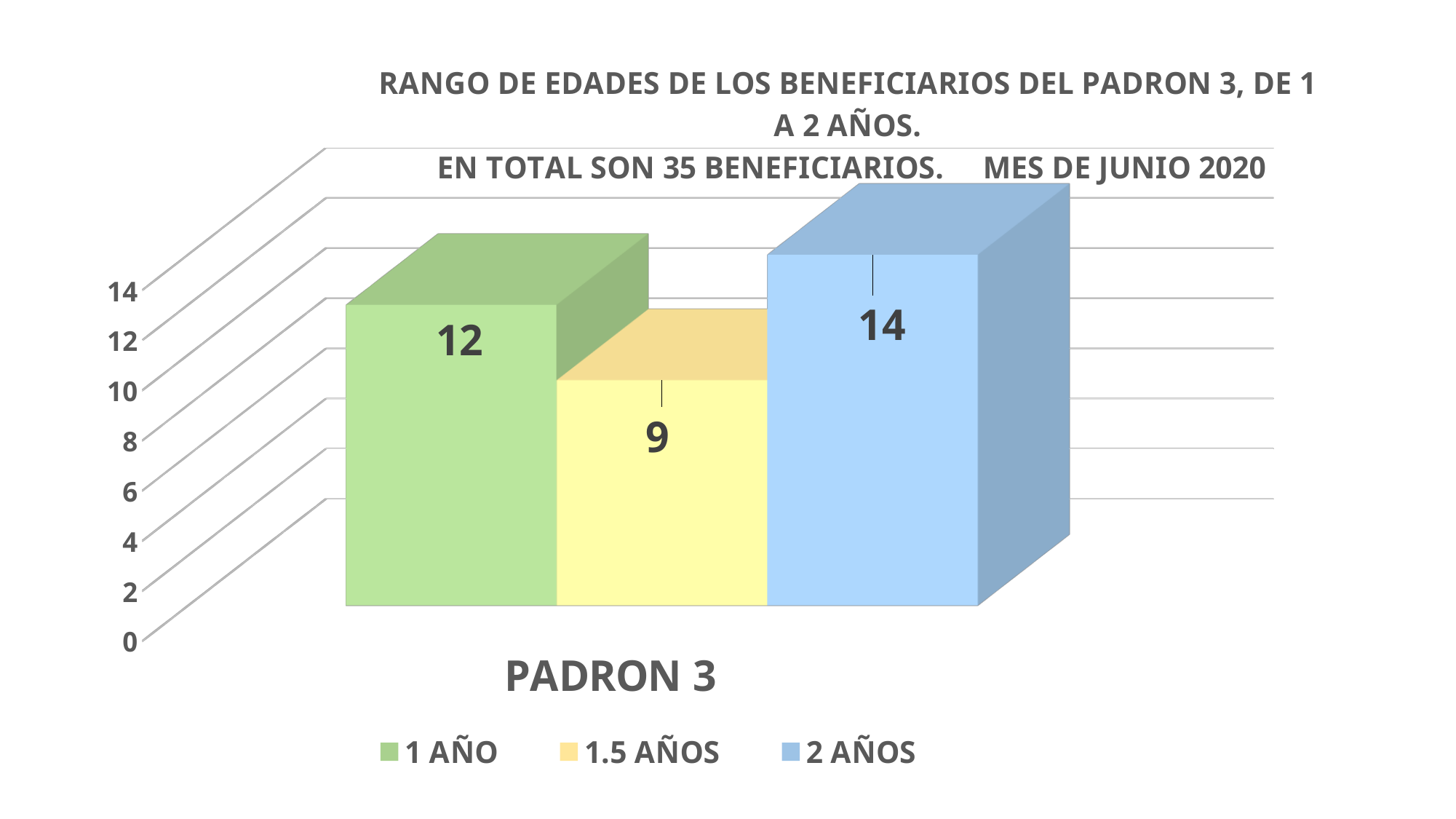
What is the difference between the values for 2 AÑOS and 1.5 AÑOS? 5 Which series has the highest value? 2 AÑOS What is the difference between the values for 2 AÑOS and 1 AÑO? 2 What is the value for the 2 AÑOS series? 14 Which is larger, the value for 1 AÑO or the value for 1.5 AÑOS? 1 AÑO Is the value for 1.5 AÑOS greater or less than 10? less What kind of chart is shown on the slide? bar chart Which series has the lowest value? 1.5 AÑOS What is the category label shown on the x axis? PADRON 3 What is the value for the 1 AÑO series? 12 What is the value for the 1.5 AÑOS series? 9 How many series does the legend list? 3